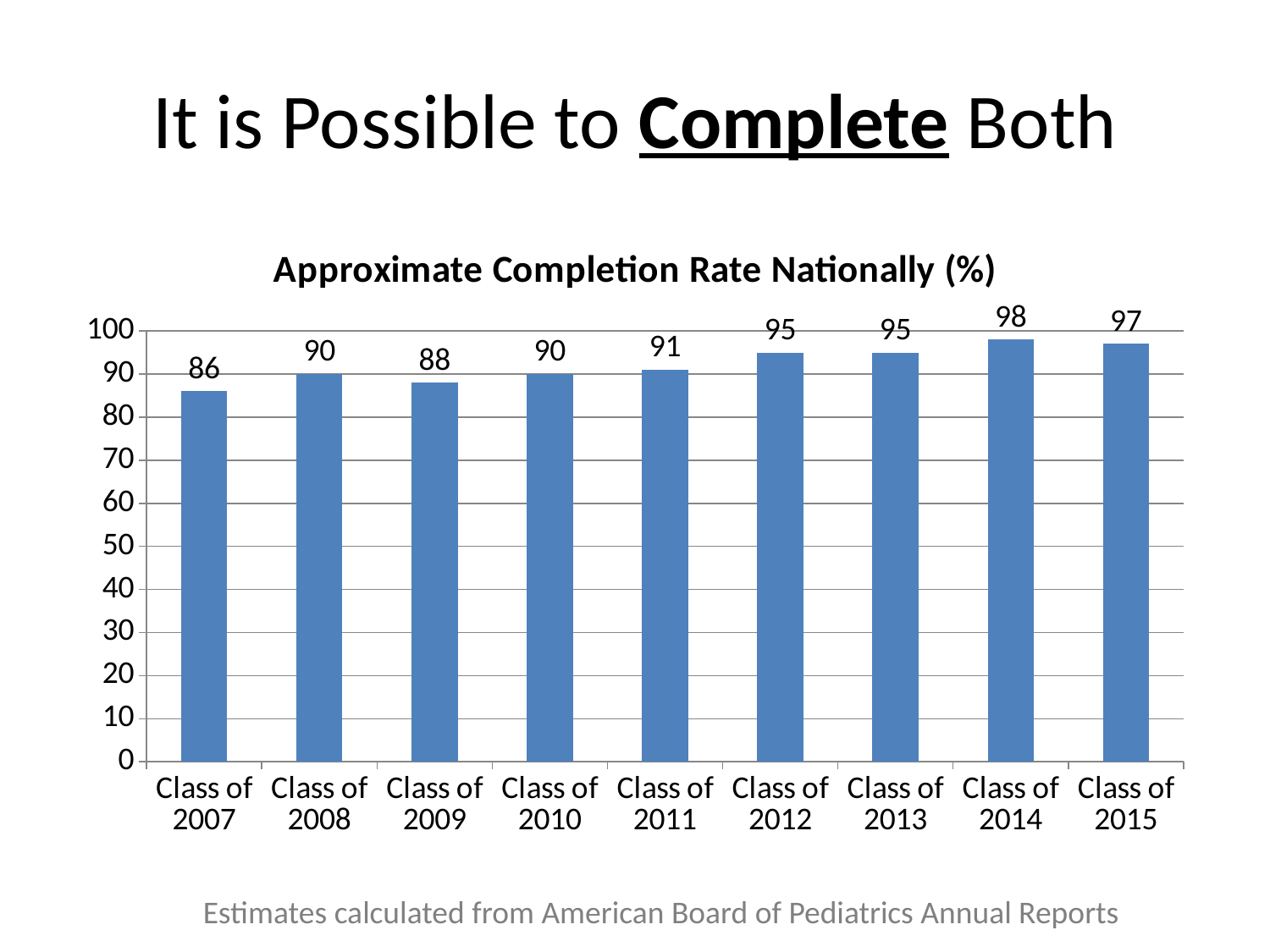
Is the value for the Class of 2008 greater or less than 80? greater What is the approximate completion rate for the Class of 2011? 91 What kind of chart is shown on the slide? Bar chart What is the approximate completion rate for the Class of 2007? 86 Which class has the highest approximate completion rate? Class of 2014 What is the difference between the completion rates of the Class of 2014 and the Class of 2007? 12 Do the completion rates generally rise or fall from the Class of 2007 to the Class of 2015? Rise Which has a higher completion rate, the Class of 2009 or the Class of 2012? Class of 2012 How many classes are shown on the chart? 9 What is the title of the chart? Approximate Completion Rate Nationally (%) What is the approximate completion rate for the Class of 2015? 97 Which class has the lowest approximate completion rate? Class of 2007